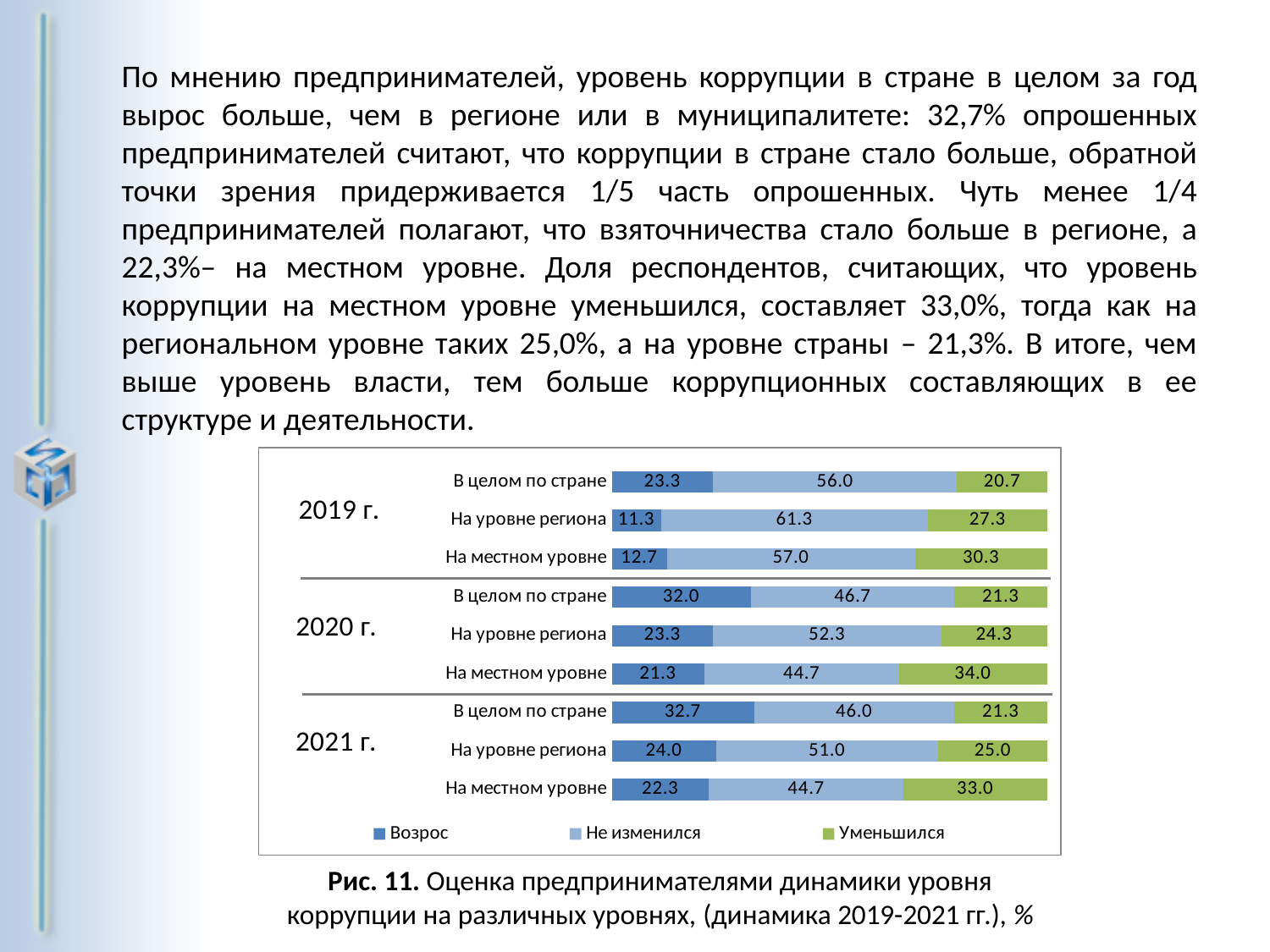
What kind of chart is shown on the slide? Stacked bar chart How many bars are plotted in the chart? 9 Does the 'Возрос' value for 'В целом по стране' rise or fall from 2019 г. to 2021 г.? Rises Which bar has the highest 'Возрос' value? В целом по стране, 2021 г. What is the total of the stacked bar for 'В целом по стране' in 2021 г.? 100.0 In 2021 г., how much larger is the 'Уменьшился' value for 'На местном уровне' than for 'В целом по стране'? 11.7 Which bar has the lowest 'Возрос' value? На уровне региона, 2019 г. What is the value of the 'Не изменился' segment for 'На уровне региона' in 2019 г.? 61.3 How many series does the legend list? 3 In 2019 г., which has the larger 'Не изменился' value: 'На уровне региона' or 'В целом по стране'? На уровне региона What is the value of the 'Уменьшился' segment for 'На местном уровне' in 2020 г.? 34.0 What is the value of the 'Возрос' segment for 'В целом по стране' in 2021 г.? 32.7